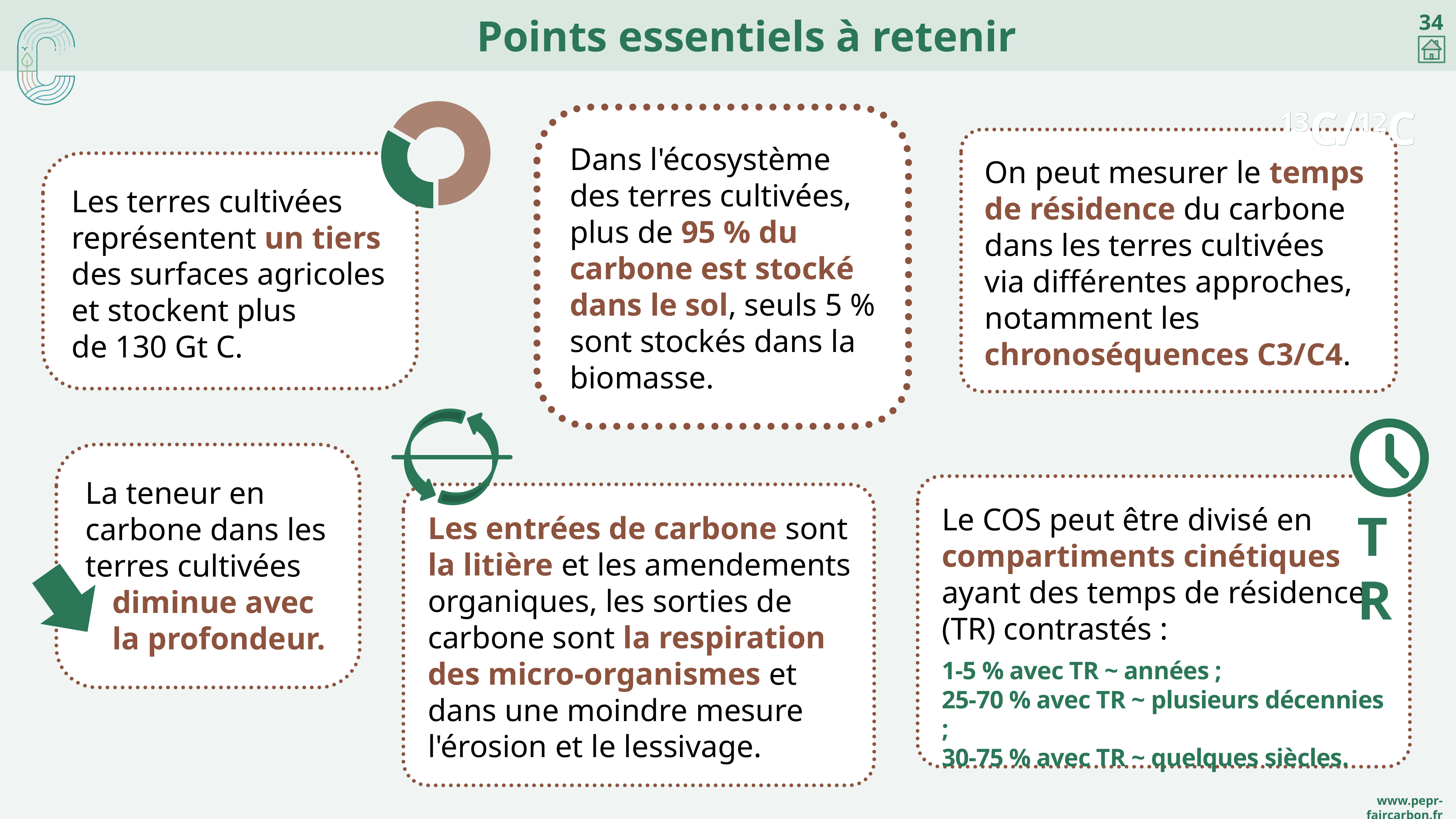
In the donut chart at the top of the slide, which slice is the smallest? The green slice What kind of chart is the small graphic next to the top-left text box? Pie (donut) chart Does the donut chart at the top of the slide show a legend? No What two colours are used for the slices of the donut chart at the top of the slide? Green and brown How many slices does the donut chart at the top of the slide have? 2 In the donut chart at the top of the slide, which slice is larger, the green one or the brown one? The brown one